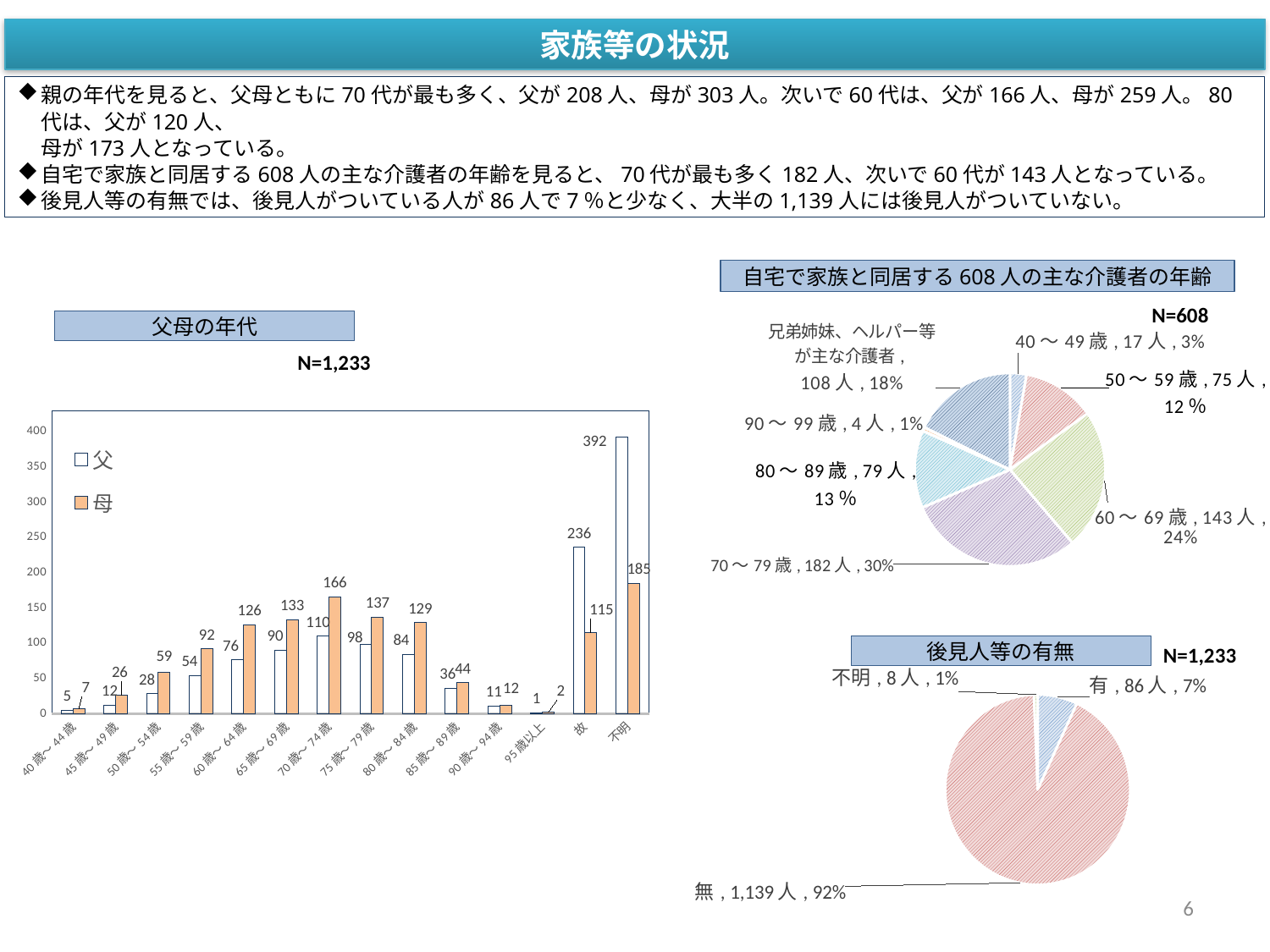
「父母の年代」のグラフで、父の値が最も大きいカテゴリはどれですか？ 不明 「父母の年代」のグラフは、どの種類のグラフですか？ 棒グラフ 「父母の年代」のグラフで、70歳～74歳の母の値はいくつですか？ 166 「父母の年代」のグラフで、55歳～59歳の父の値はいくつですか？ 54 「後見人等の有無」のグラフで、「無」の人数と割合はいくつですか？ 1,139人, 92% 「自宅で家族と同居する608人の主な介護者の年齢」のグラフで、60～69歳の人数はいくつですか？ 143人 「父母の年代」のグラフで、母の値が最も小さいカテゴリはどれですか？ 95歳以上 「父母の年代」のグラフで、80歳～84歳では父と母のどちらの値が大きいですか？ 母 「自宅で家族と同居する608人の主な介護者の年齢」のグラフで、最も人数が少ない区分はどれですか？ 90～99歳 「父母の年代」のグラフで、「故」の父と母の値の差はいくつですか？ 121 「父母の年代」のグラフの凡例には、いくつの系列がありますか？ 2 「自宅で家族と同居する608人の主な介護者の年齢」のグラフで、70～79歳の割合は何％ですか？ 30%